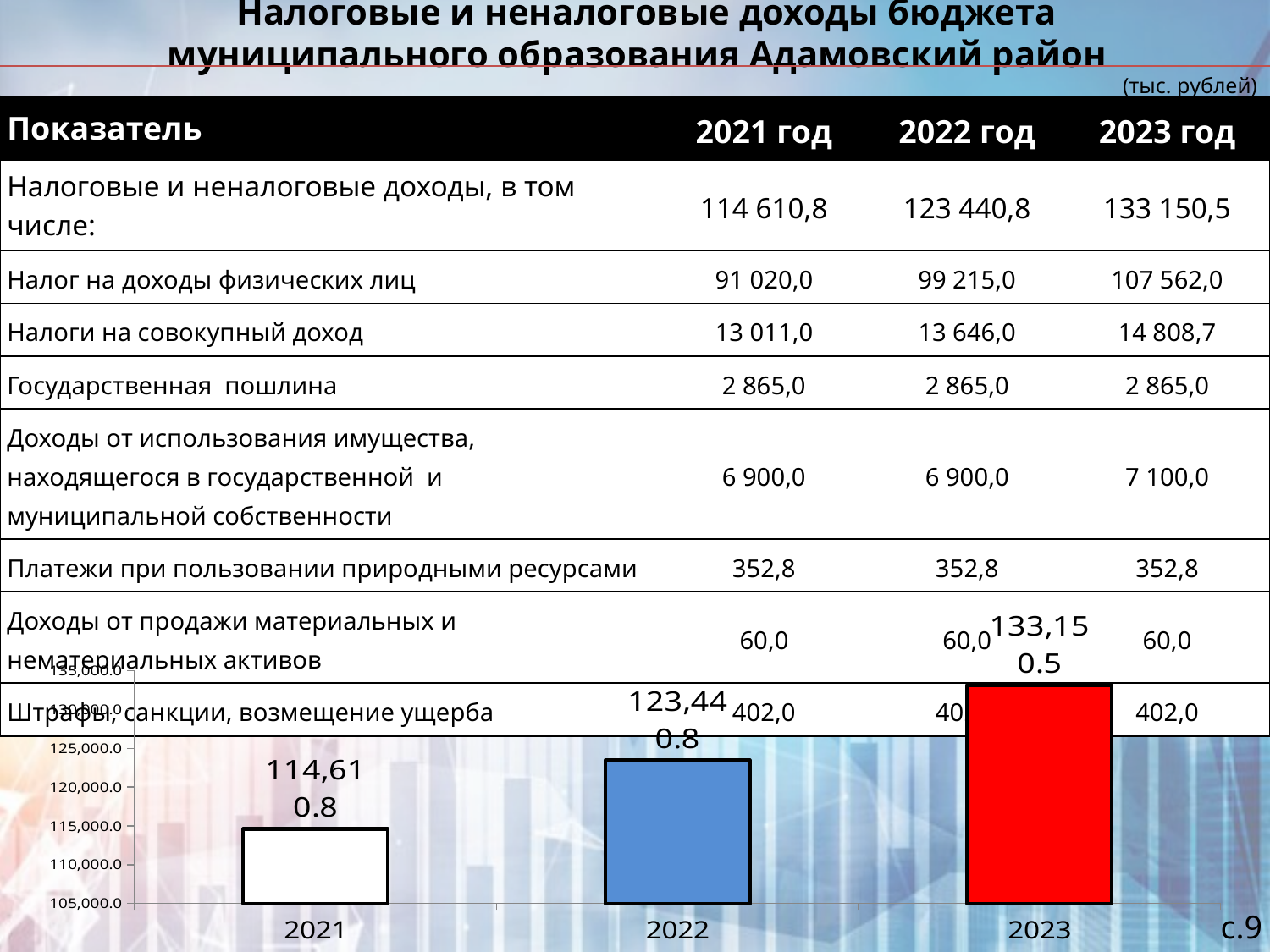
What is the value shown for 2022 in the bar chart? 123,440.8 What is the difference between the 2023 and 2022 values in the bar chart? 9,709.7 What kind of chart is shown at the bottom of the slide? bar chart In the bar chart, which is larger: the value for 2021 or the value for 2023? 2023 What is the value shown for 2023 in the bar chart? 133,150.5 Which year has the lowest bar in the chart? 2021 Do the values in the bar chart rise or fall from 2021 to 2023? rise What is the value shown for 2021 in the bar chart? 114,610.8 Is the value for 2022 in the bar chart greater or less than 120,000.0? greater What is the difference between the 2022 and 2021 values in the bar chart? 8,830.0 How many bars are plotted in the chart? 3 Which year has the highest bar in the chart? 2023